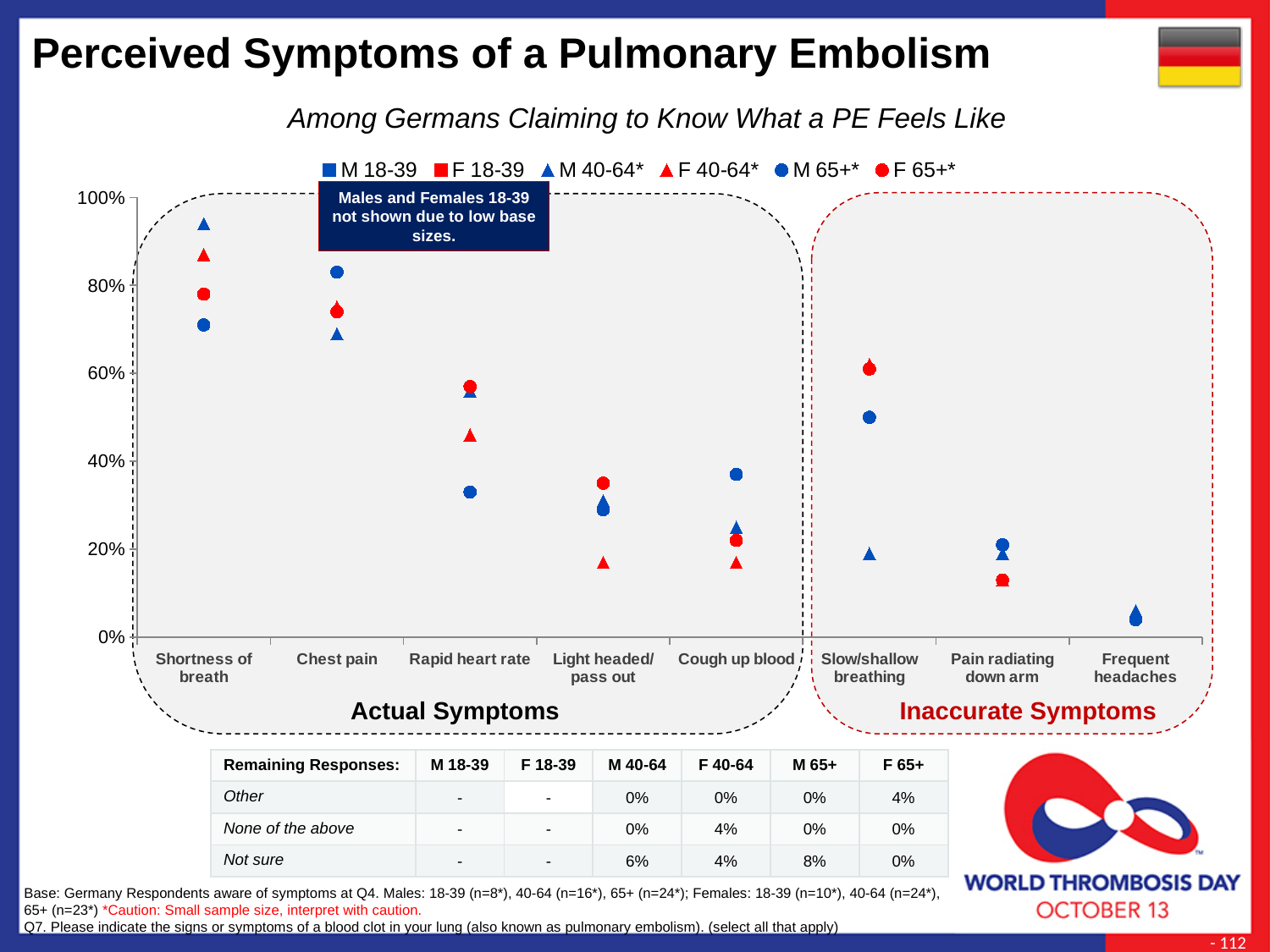
How many symptom categories are shown on the x axis of the chart? 8 Is the value for F 65+ for Pain radiating down arm greater or less than 20%? less Is the value for M 65+ for Chest pain greater or less than 80%? greater Which two series are not shown on the chart due to low base sizes? M 18-39 and F 18-39 Is the value for M 65+ for Rapid heart rate greater or less than 40%? less For Rapid heart rate, which is larger: the M 65+ value or the F 65+ value? F 65+ What kind of chart is shown on the slide? scatter chart Which symptom has the lowest values across all plotted series? Frequent headaches How many series does the chart legend list? 6 For which symptom is the M 40-64 value highest? Shortness of breath